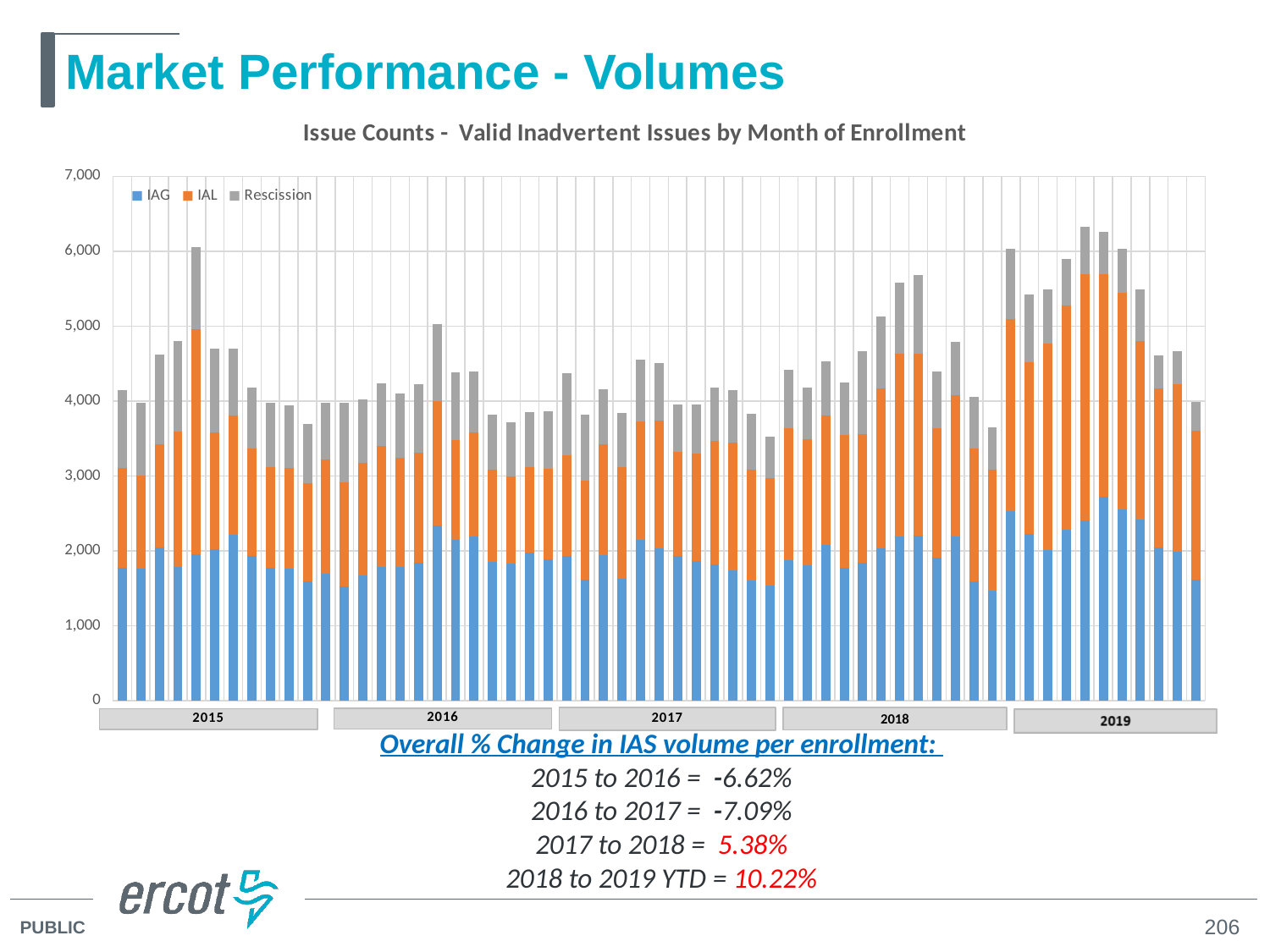
How many series does the legend list? 3 What is the title of the chart? Issue Counts - Valid Inadvertent Issues by Month of Enrollment What is the maximum value shown on the y axis? 7,000 What are the three series named in the legend? IAG, IAL, Rescission How many year groups are labeled along the x axis? 5 Is the total of the tallest stacked bar greater or less than 6,000? greater Is the total of the shortest stacked bar greater or less than 4,000? less Which series forms the bottom segment of each stacked bar? IAG Which year group has the tallest bar: 2016 or 2019? 2019 Is the IAG segment of the tallest bar in 2019 greater or less than 3,000? less Which year group contains the tallest stacked bar? 2019 What kind of chart is shown on the slide? Stacked bar chart